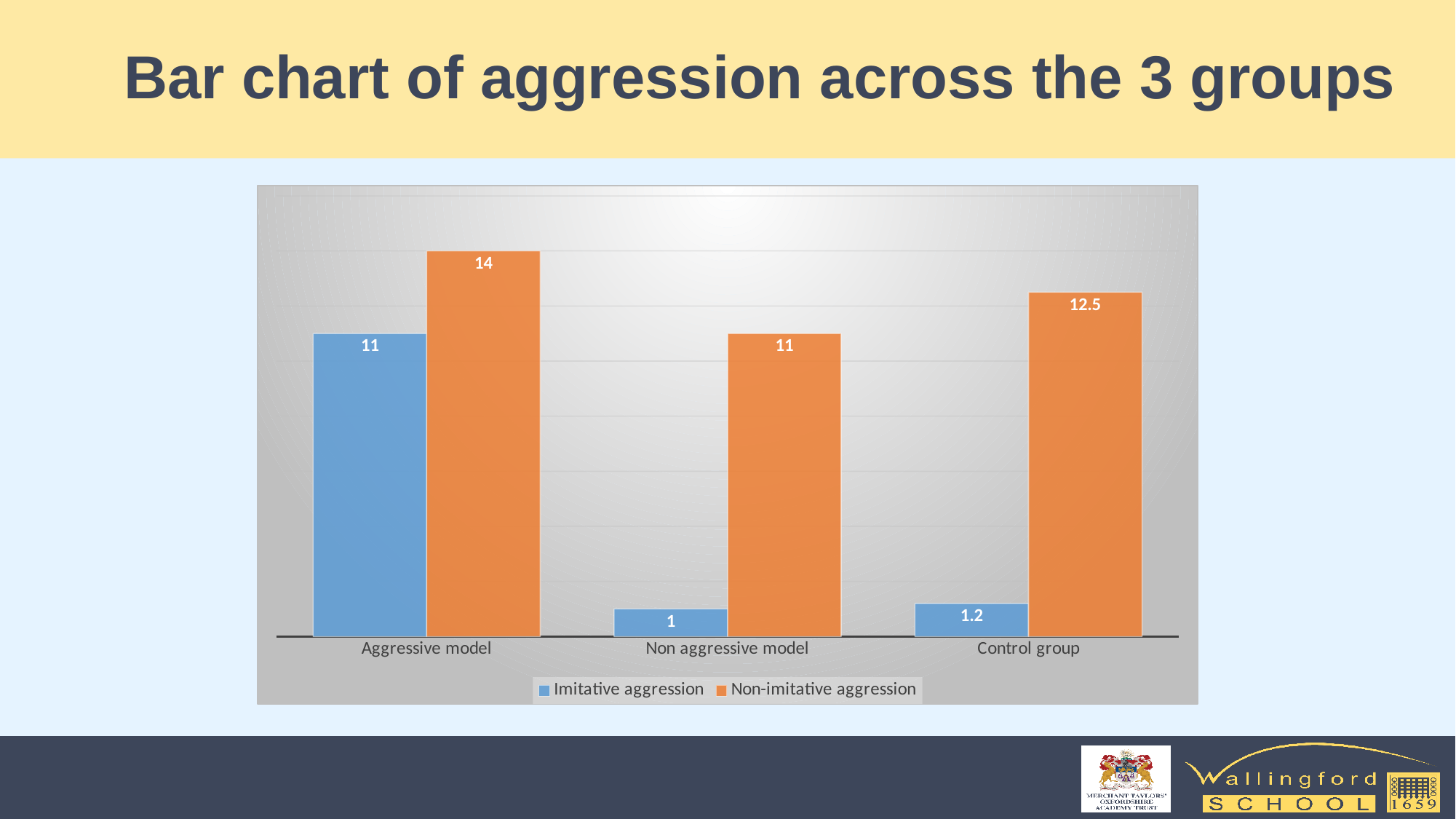
Which group has the lowest Imitative aggression value? Non aggressive model How many series does the legend list? 2 How many groups are shown on the x axis? 3 What is the value of Imitative aggression for the Aggressive model group? 11 What is the value of Non-imitative aggression for the Aggressive model group? 14 What type of chart is shown on the slide? Bar chart Which group has the highest Non-imitative aggression value? Aggressive model What is the value of Imitative aggression for the Non aggressive model group? 1 What is the difference between Non-imitative aggression and Imitative aggression for the Aggressive model group? 3 Which is larger: Non-imitative aggression for the Control group or Non-imitative aggression for the Non aggressive model group? Control group What is the value of Non-imitative aggression for the Control group? 12.5 What is the value of Imitative aggression for the Control group? 1.2